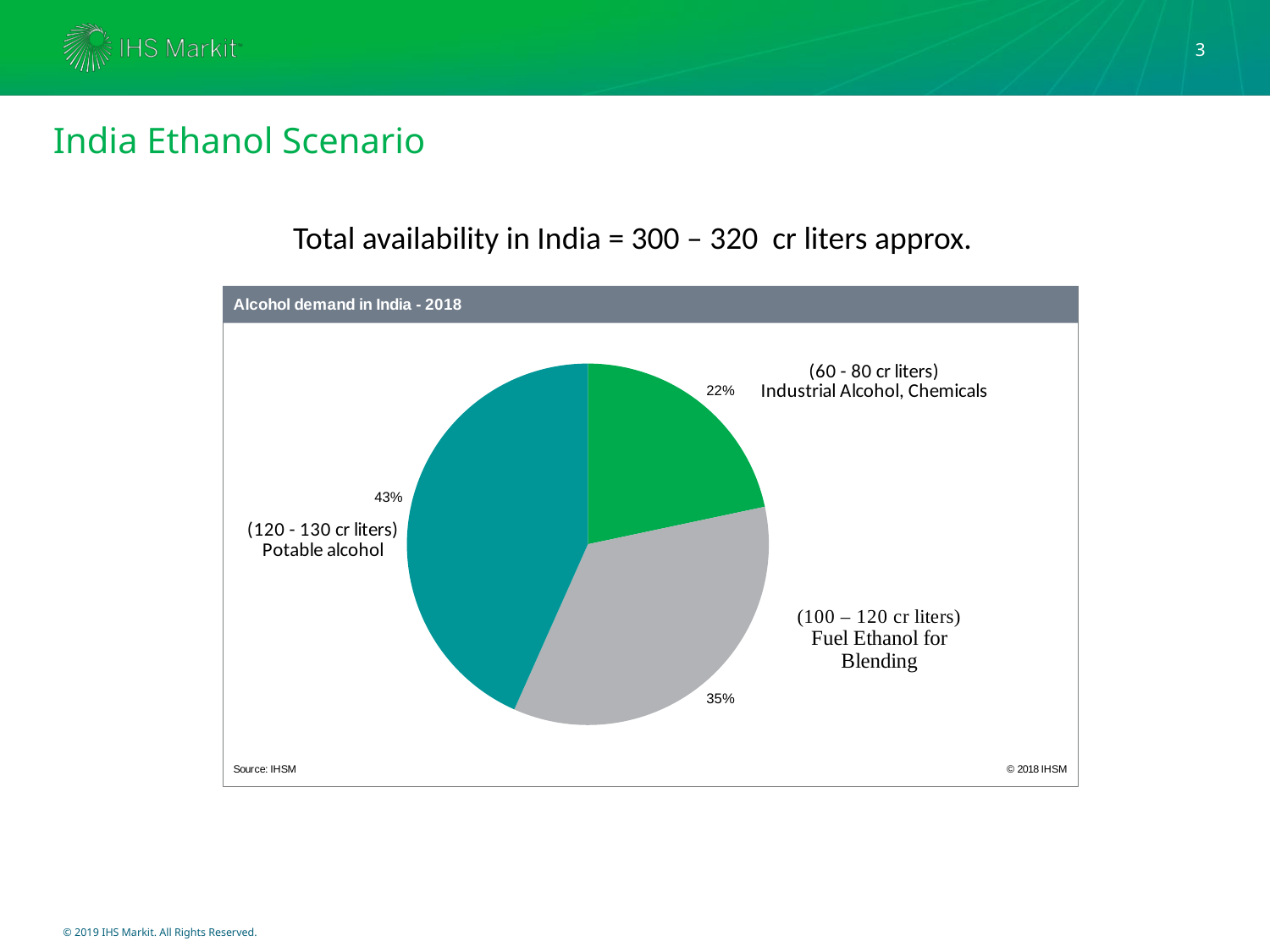
What is the difference in percentage points between the Potable alcohol share and the Fuel Ethanol for Blending share? 8 What is the title of the chart? Alcohol demand in India - 2018 Which category has the largest share of the pie? Potable alcohol Which is larger, the share for Fuel Ethanol for Blending or the share for Industrial Alcohol, Chemicals? Fuel Ethanol for Blending What share of the pie is Industrial Alcohol, Chemicals? 22% What kind of chart is shown on the slide? pie chart What volume range is given for Industrial Alcohol, Chemicals? 60 - 80 cr liters What share of the pie is Potable alcohol? 43% Which category has the smallest share of the pie? Industrial Alcohol, Chemicals What volume range is given for Potable alcohol? 120 - 130 cr liters What share of the pie is Fuel Ethanol for Blending? 35% How many slices does the pie chart have? 3